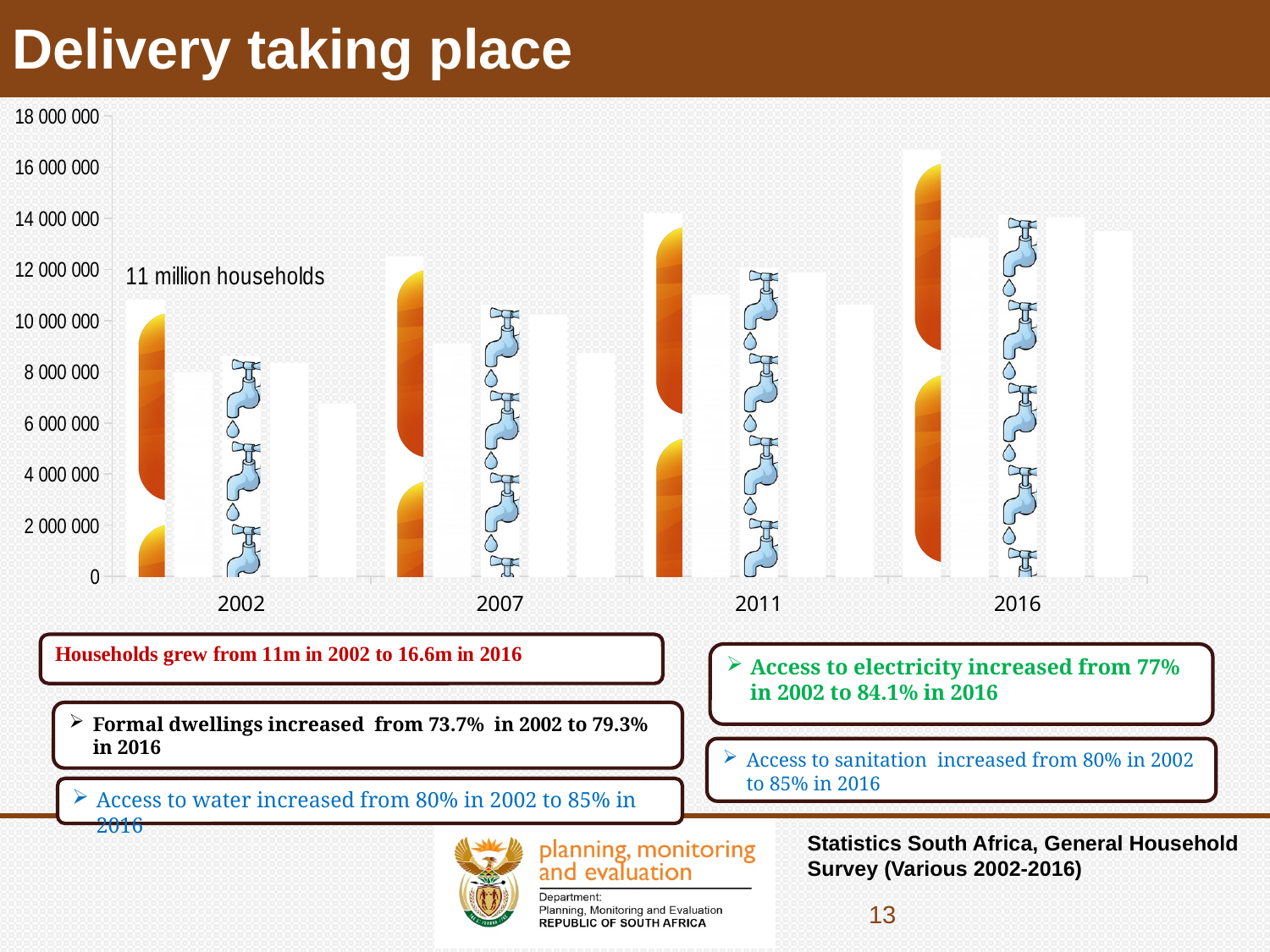
Does the leftmost bar in each year group rise or fall from 2002 to 2016? rise Which years are shown on the x axis of the chart? 2002, 2007, 2011, 2016 Which is larger, the leftmost bar for 2002 or the leftmost bar for 2016? 2016 Is the leftmost bar for 2011 greater or less than 12 000 000? greater In which year is the tallest bar of the chart found? 2016 Is the leftmost bar for 2007 greater or less than 14 000 000? less Is the leftmost bar for 2002 greater or less than 10 000 000? greater What value does the annotation on the chart give for households in 2002? 11 million households What kind of chart is shown on the slide? bar chart What is the highest value shown on the y axis of the chart? 18 000 000 How many years are shown along the x axis of the chart? 4